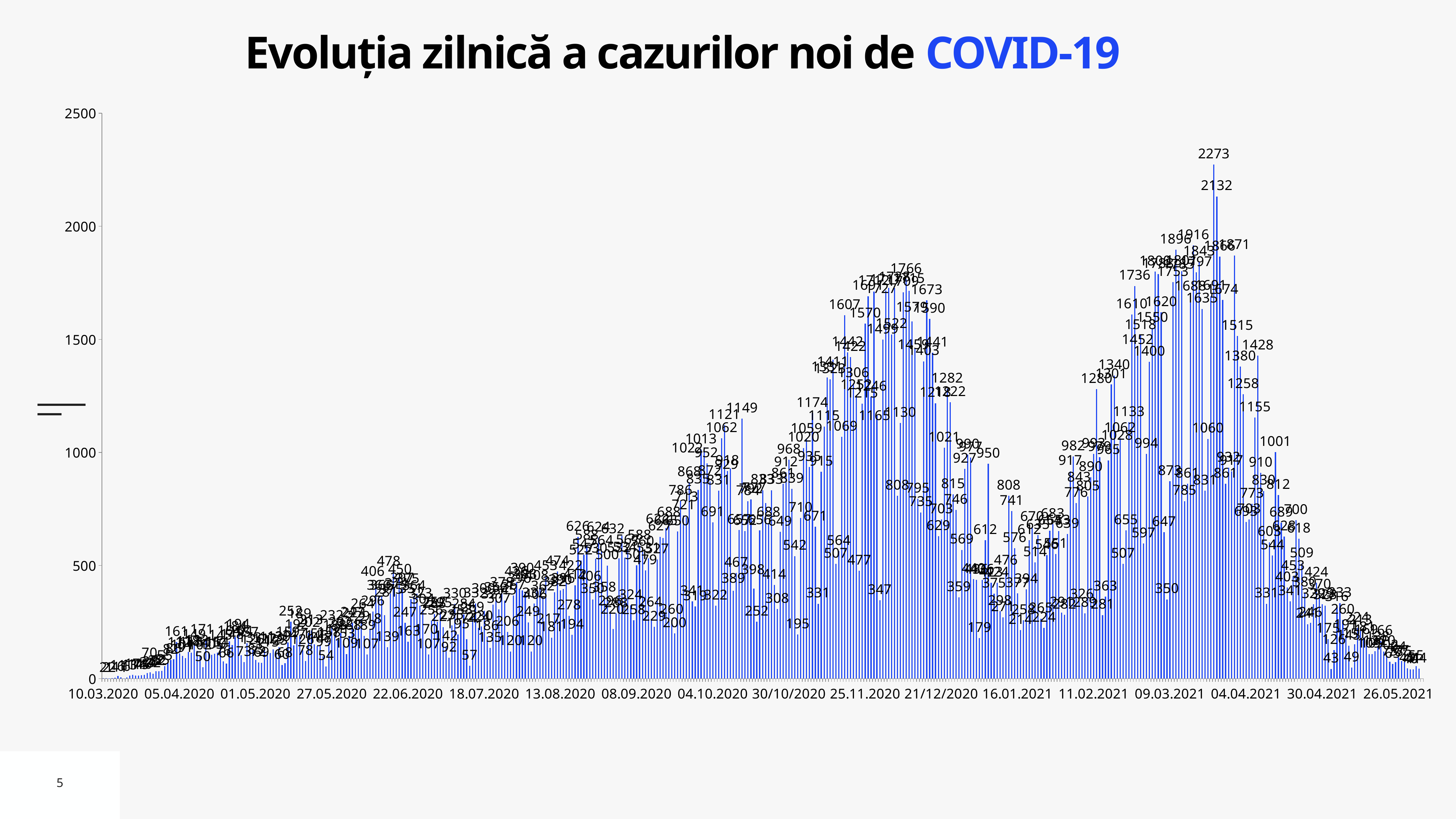
What is the title of the chart? Evoluția zilnică a cazurilor noi de COVID-19 Is the value for 10.03.2020 greater or less than 500? less Is the value for 26.05.2021 greater or less than 500? less Which period has the higher peak: around 25.11.2020 or around 04.04.2021? around 04.04.2021 Do the values generally rise or fall between 10.03.2020 and 22.06.2020? rise What is the difference between the two highest labelled values, 2273 and 2132? 141 What is the highest value shown on the vertical axis? 2500 What is the second-highest daily value labelled on the chart, next to the 2273 peak? 2132 What kind of chart is shown on the slide? bar chart Do the values generally rise or fall between 04.04.2021 and 26.05.2021? fall What is the highest daily value labelled on the chart? 2273